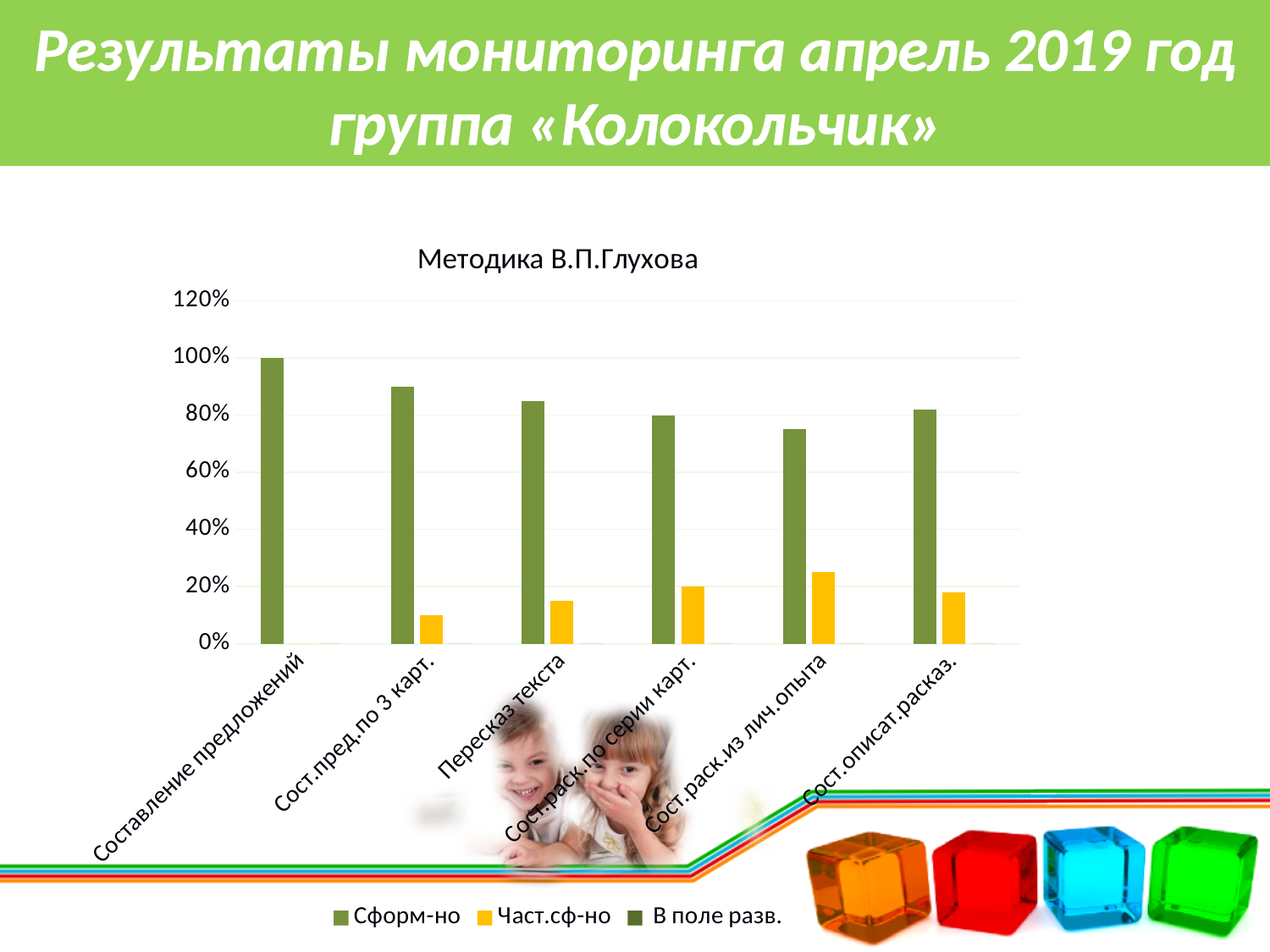
How many series does the chart legend list? 3 What kind of chart is shown on the slide? bar chart Which is larger: Сформ-но for Составление предложений or Сформ-но for Сост.раск.из лич.опыта? Составление предложений Is the value of Част.сф-но for Сост.пред.по 3 карт. greater or less than 20%? less What is the title of the chart? Методика В.П.Глухова Which category has the highest value for Сформ-но? Составление предложений Which category has the lowest value for Сформ-но? Сост.раск.из лич.опыта Which category has the highest value for Част.сф-но? Сост.раск.из лич.опыта Is the value of Сформ-но for Пересказ текста greater or less than 80%? greater What is the value of Сформ-но for Составление предложений? 100% Which legend series is shown in yellow? Част.сф-но How many categories are shown on the x axis of the chart? 6